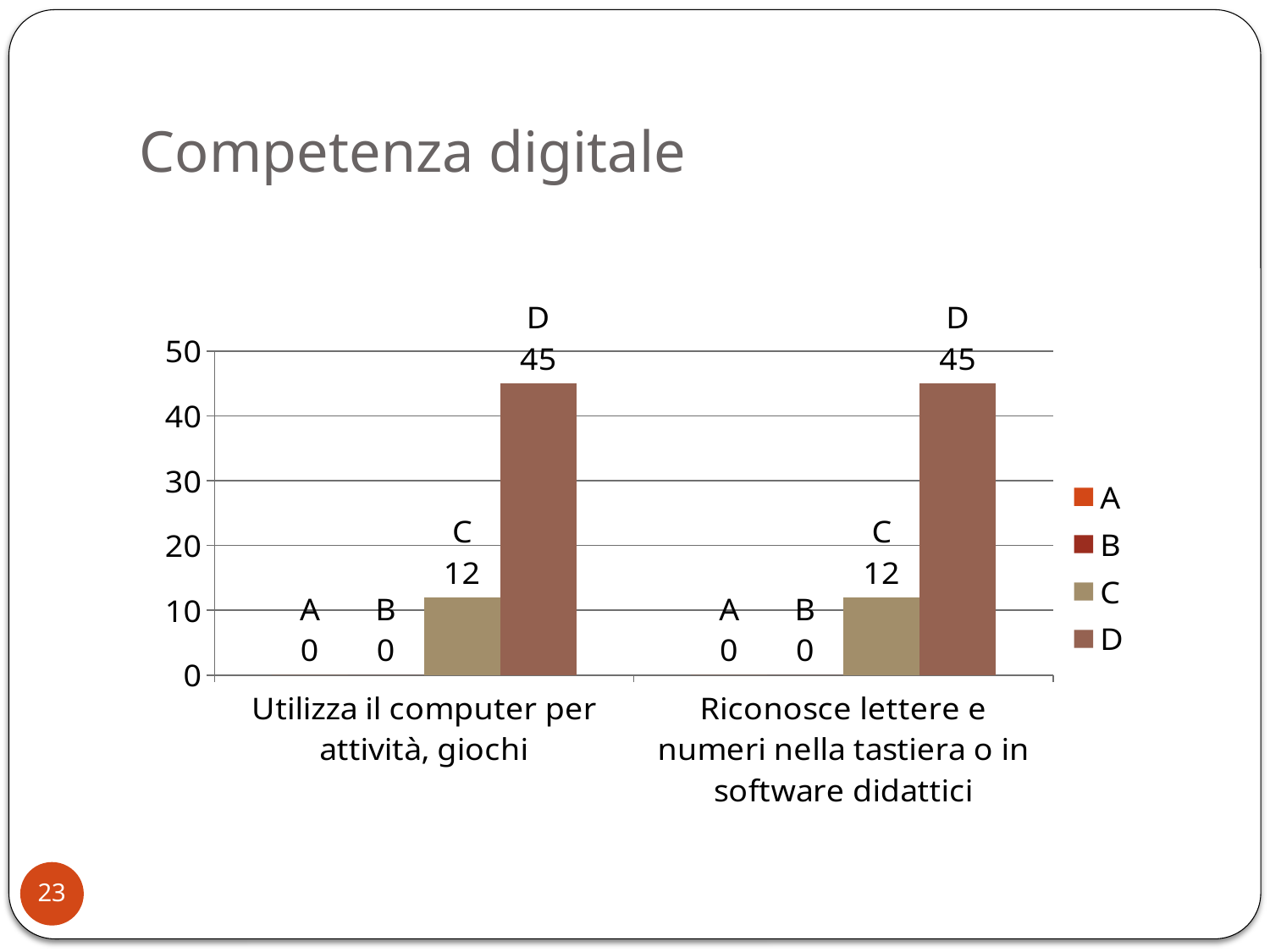
What is the value for series B in the category "Riconosce lettere e numeri nella tastiera o in software didattici"? 0 What is the value for series D in the category "Utilizza il computer per attività, giochi"? 45 What is the value for series C in the category "Riconosce lettere e numeri nella tastiera o in software didattici"? 12 What is the difference between the values for series D and series C in the category "Riconosce lettere e numeri nella tastiera o in software didattici"? 33 Which is larger in the category "Utilizza il computer per attività, giochi": the value for series C or the value for series D? D How many series does the legend list? 4 Is the value for series D in the category "Riconosce lettere e numeri nella tastiera o in software didattici" greater or less than 40? greater What is the value for series A in the category "Utilizza il computer per attività, giochi"? 0 What is the title of the slide containing the chart? Competenza digitale What kind of chart is shown on the slide? bar chart How many categories are shown on the x axis? 2 Which series has the highest value in the category "Utilizza il computer per attività, giochi"? D